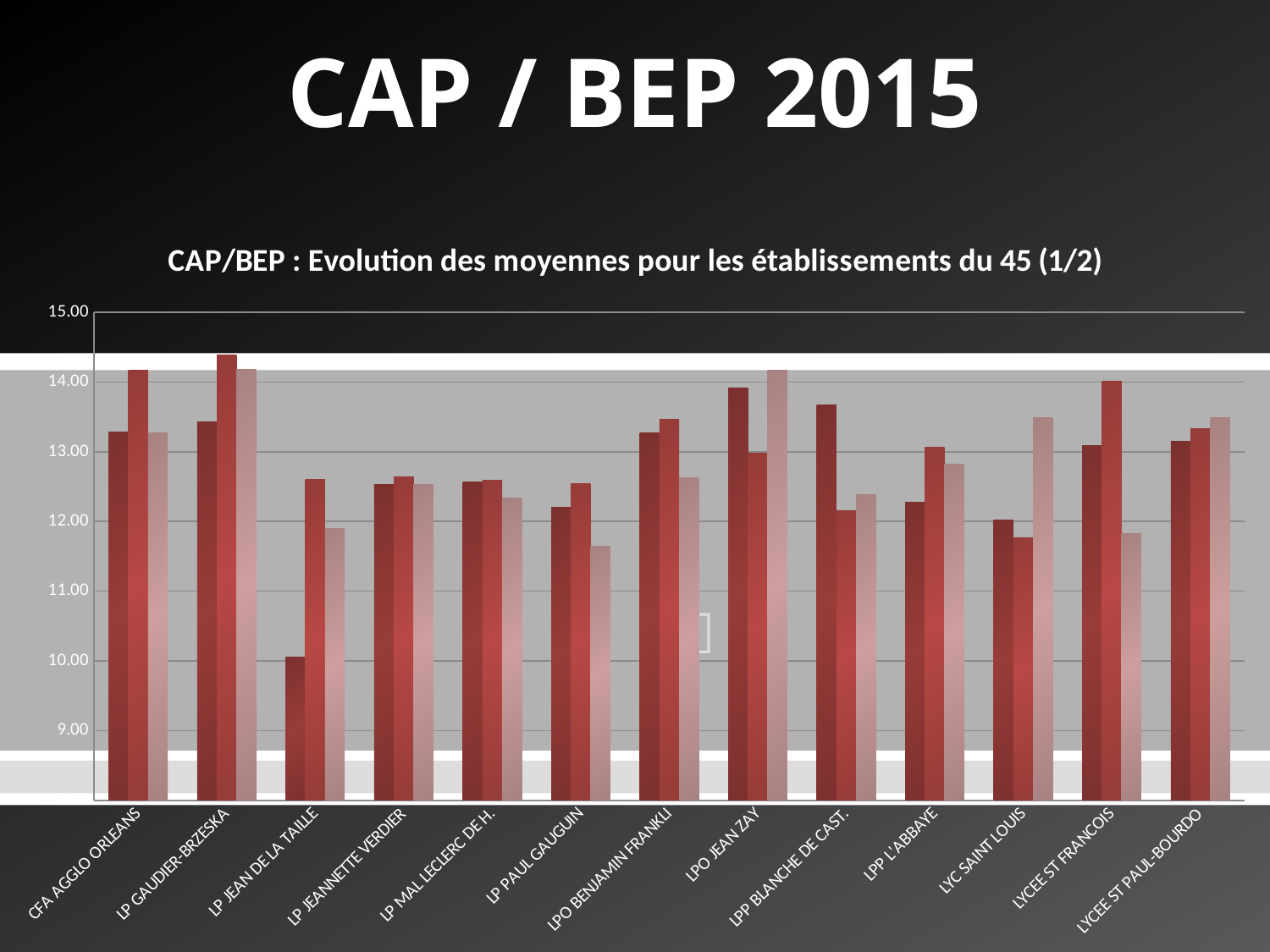
Is the first bar for LPO JEAN ZAY greater or less than 13.00? greater Is the third bar for LYCEE ST FRANCOIS greater or less than 12.00? less What is the highest value shown on the y axis of the chart? 15.00 Which is taller: the second bar for CFA AGGLO ORLEANS or the second bar for LPP L'ABBAYE? CFA AGGLO ORLEANS Which is taller: the first bar for LPO JEAN ZAY or the first bar for LP PAUL GAUGUIN? LPO JEAN ZAY Is the first bar for LP JEAN DE LA TAILLE greater or less than 11.00? less What is the title of the chart? CAP/BEP : Evolution des moyennes pour les établissements du 45 (1/2) What kind of chart is shown on the slide? bar chart How many establishments (categories) are shown on the x axis of the chart? 13 Which establishment has the lowest bar in the chart? LP JEAN DE LA TAILLE